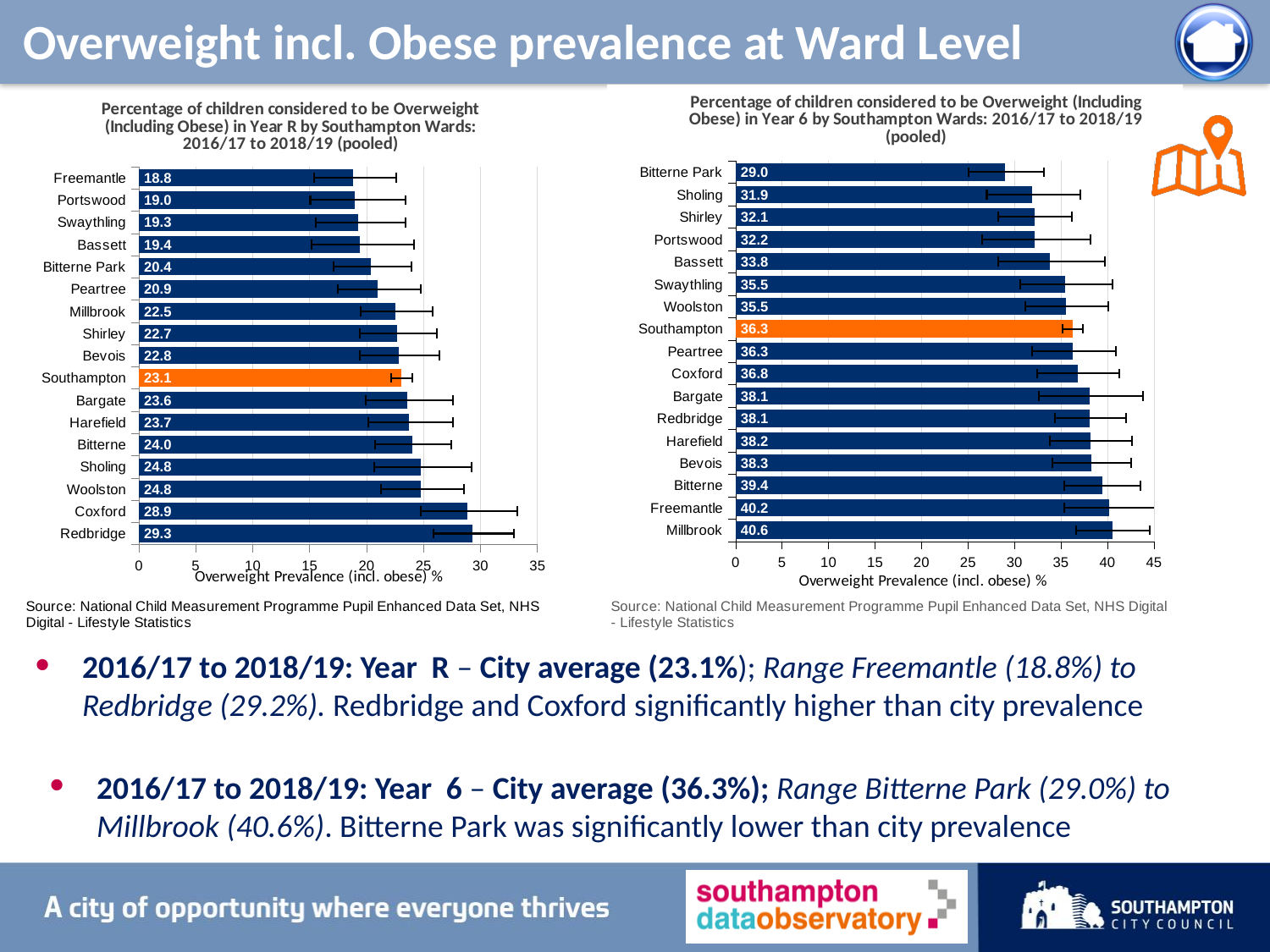
In the Year R chart on the left, how many bars are plotted? 17 What type of chart is the Year R chart on the left? Bar chart In the Year R chart on the left, what is the difference between Redbridge and Coxford? 0.4 In the Year R chart on the left, what is the value for Freemantle? 18.8 In the Year 6 chart on the right, what is the difference between Millbrook and Bitterne Park? 11.6 In the Year R chart on the left, which ward has the highest value? Redbridge In the Year 6 chart on the right, which is larger, the value for Bitterne or the value for Bassett? Bitterne In the Year 6 chart on the right, which bar is coloured orange? Southampton In the Year 6 chart on the right, is the value for Sholing greater or less than 35? less In the Year 6 chart on the right, which ward has the lowest value? Bitterne Park In the Year R chart on the left, what is the value for Southampton? 23.1 In the Year 6 chart on the right, what is the value for Millbrook? 40.6